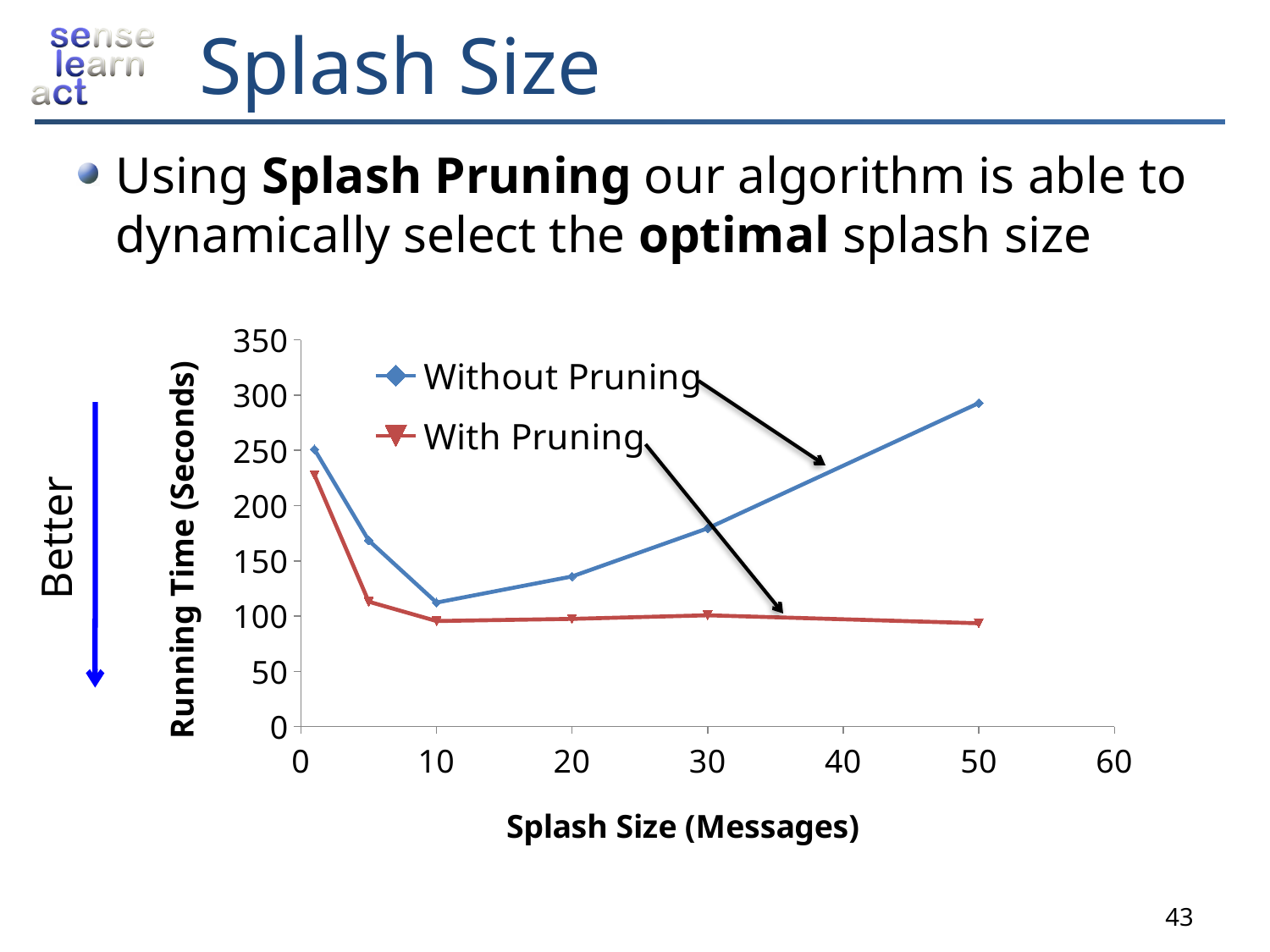
Does the With Pruning running time rise or fall between splash size 1 and splash size 10? fall What is the title of the y axis? Running Time (Seconds) What kind of chart is shown on the slide? line chart At splash size 50, which series has the higher running time, Without Pruning or With Pruning? Without Pruning Is the Without Pruning running time at splash size 30 greater or less than 150? greater Is the Without Pruning running time at splash size 50 greater or less than 250? greater Does the Without Pruning running time rise or fall between splash size 10 and splash size 50? rise Is the With Pruning running time at splash size 10 greater or less than 150? less What are the two series named in the legend? Without Pruning, With Pruning How many data points are plotted for the Without Pruning series? 6 How many series does the legend list? 2